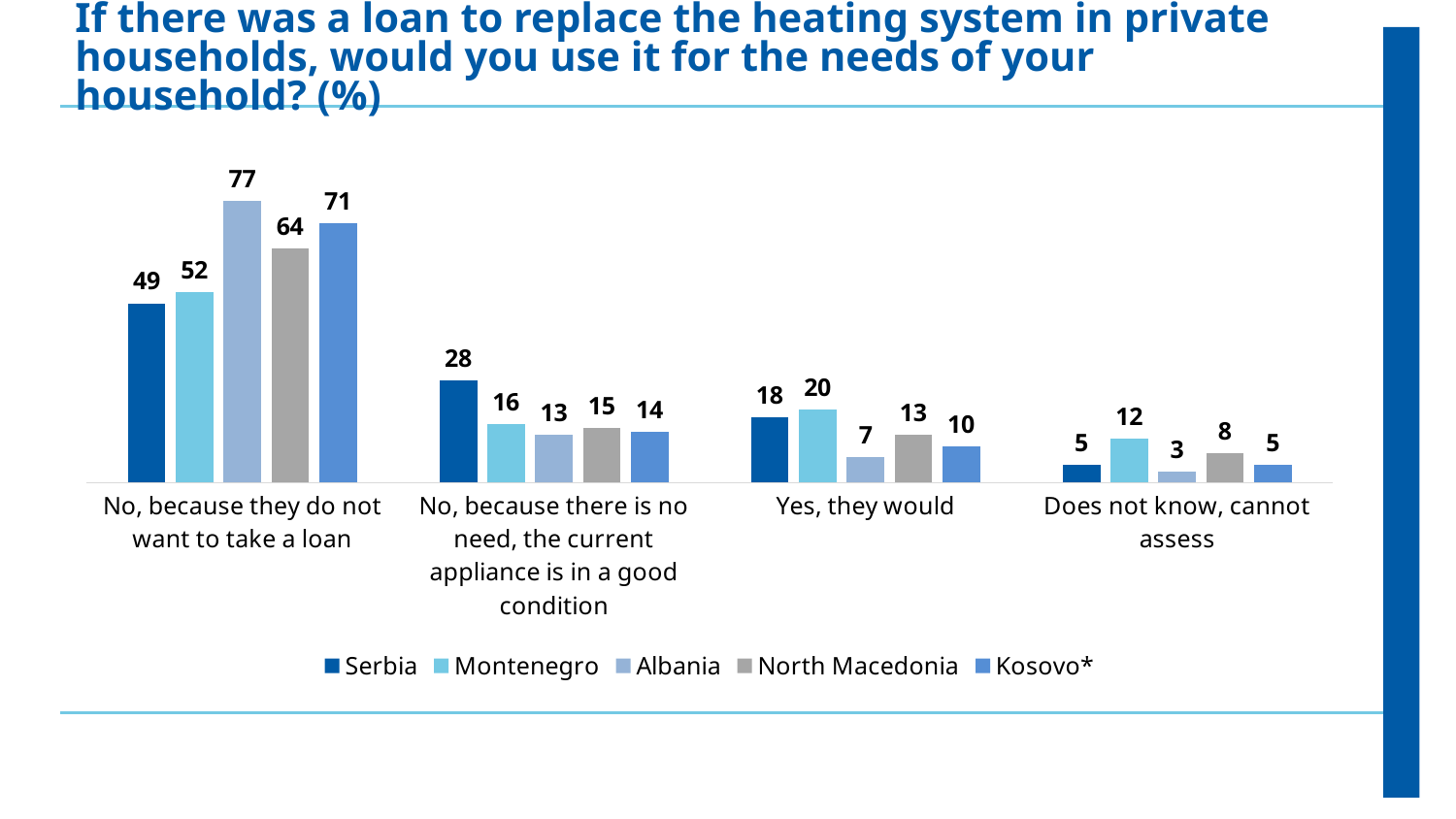
What is the value for Albania in the "No, because they do not want to take a loan" category? 77 What is the difference between Albania and Serbia in the "No, because they do not want to take a loan" category? 28 How many response categories are shown on the x axis? 4 What is the value for Serbia in the "Yes, they would" category? 18 Which is larger: Montenegro's value or Kosovo*'s value in the "Yes, they would" category? Montenegro Which series is shown in the darkest blue colour in the legend? Serbia What is the difference between Montenegro and Albania in the "Does not know, cannot assess" category? 9 How many series does the legend list? 5 Which country has the lowest value in the "Yes, they would" category? Albania What kind of chart is shown on the slide? Bar chart Which country has the highest value in the "No, because there is no need, the current appliance is in a good condition" category? Serbia What is the value for North Macedonia in the "Does not know, cannot assess" category? 8